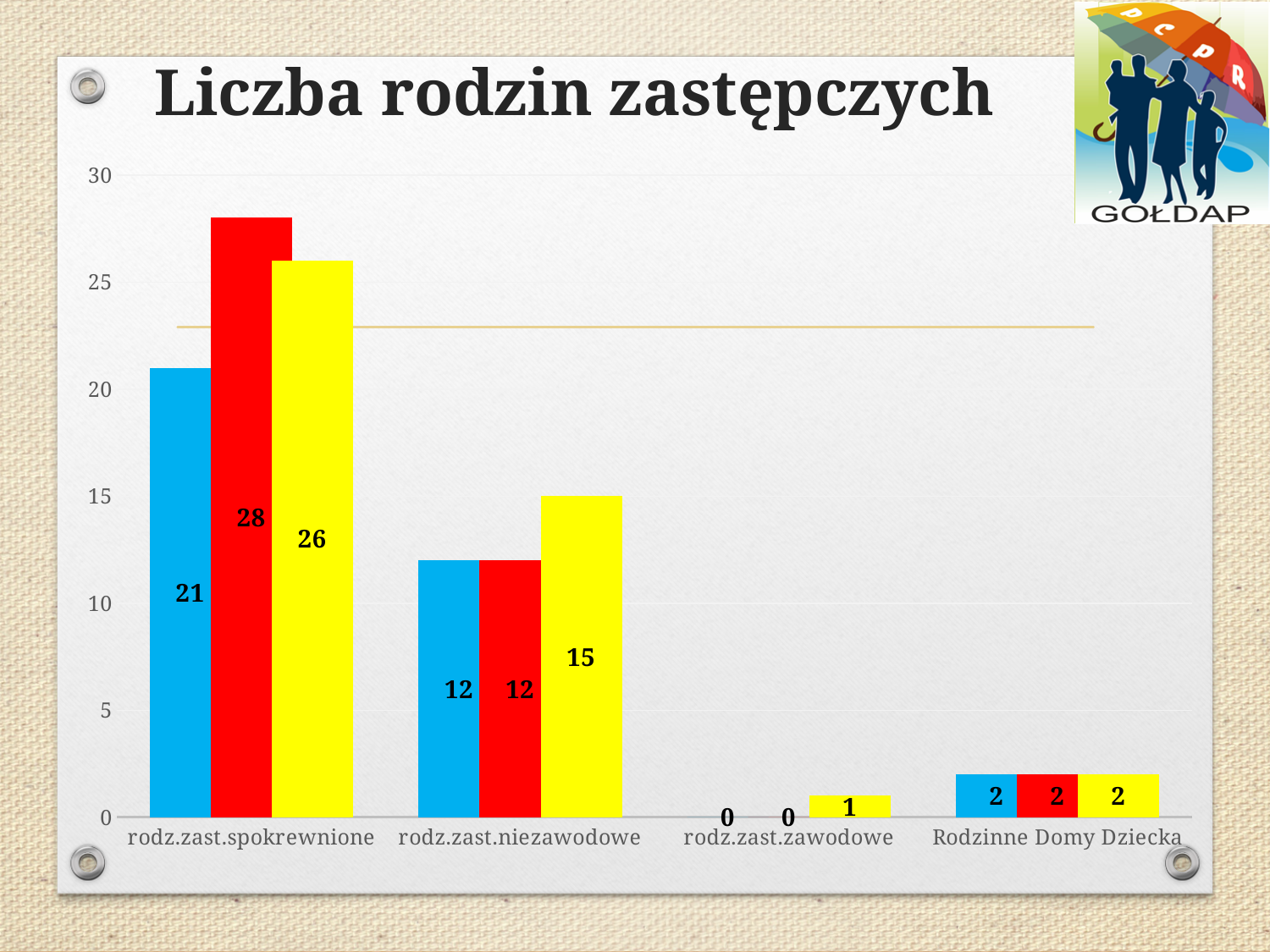
Which category has the lowest value among the yellow bars? rodz.zast.zawodowe What is the value of the blue bar for rodz.zast.zawodowe? 0 Which category has the highest value among the red bars? rodz.zast.spokrewnione What is the title of the chart? Liczba rodzin zastępczych What is the value of the red bar for rodz.zast.spokrewnione? 28 Which is larger for rodz.zast.spokrewnione: the yellow bar or the blue bar? the yellow bar What is the difference between the red bar and the blue bar for rodz.zast.spokrewnione? 7 What is the value of the yellow bar for Rodzinne Domy Dziecka? 2 How many categories are shown on the x axis of the chart? 4 How many bars are shown for each category in the chart? 3 What is the value of the yellow bar for rodz.zast.niezawodowe? 15 What type of chart is shown on the slide? bar chart